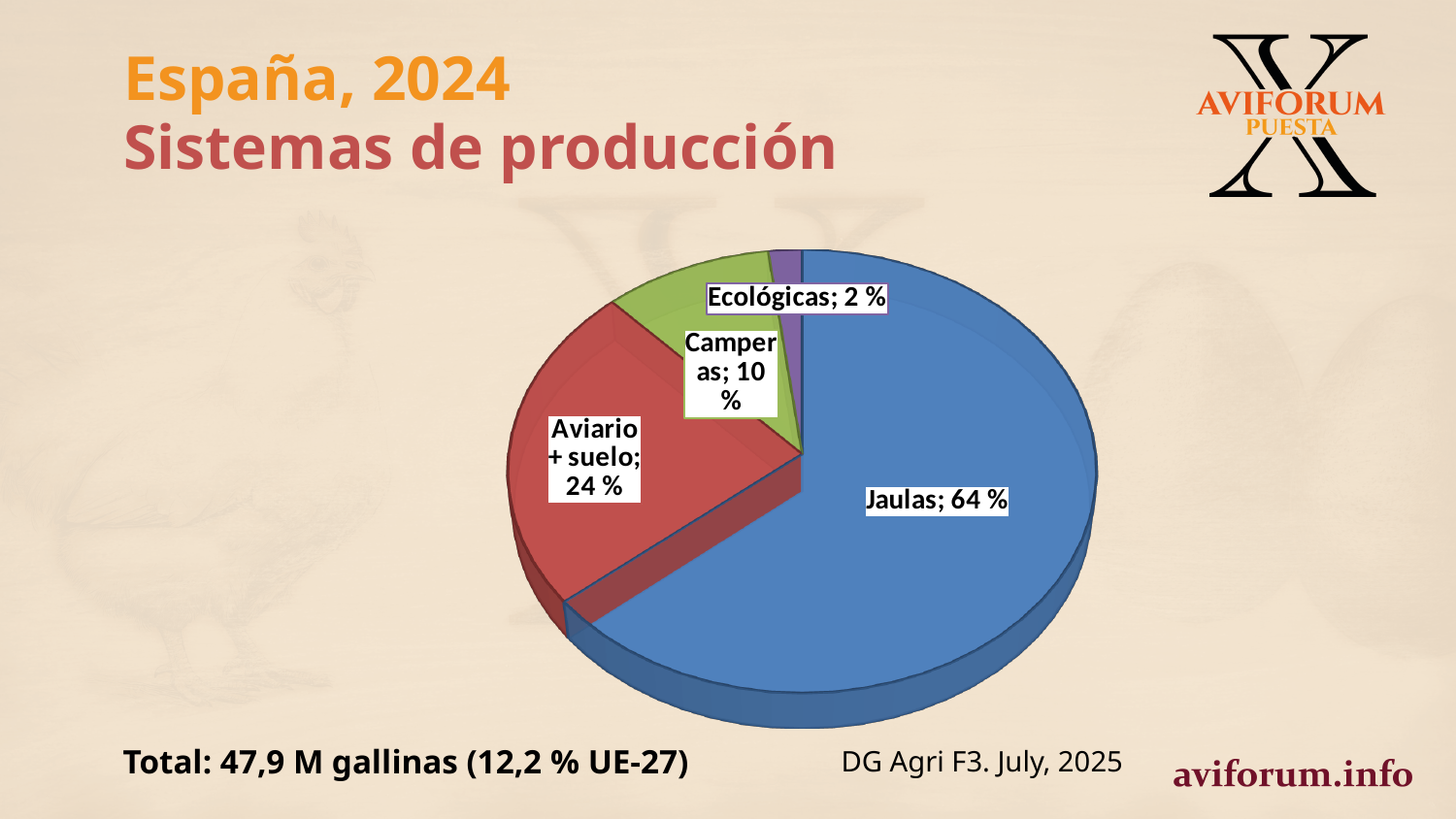
What is the value shown for Ecológicas? 2 % What kind of chart is shown on the slide? Pie chart What is the difference between the Jaulas and Aviario + suelo shares? 40 % What share of the pie does Jaulas represent? 64 % How many categories are shown in the pie chart? 4 Which category has the largest slice of the pie? Jaulas What is the difference between the Camperas and Ecológicas shares? 8 % Which is larger, the share for Camperas or the share for Aviario + suelo? Aviario + suelo What is the value shown for Aviario + suelo? 24 % Which category has the smallest slice of the pie? Ecológicas What colour is the Jaulas slice? Blue What is the value shown for Camperas? 10 %